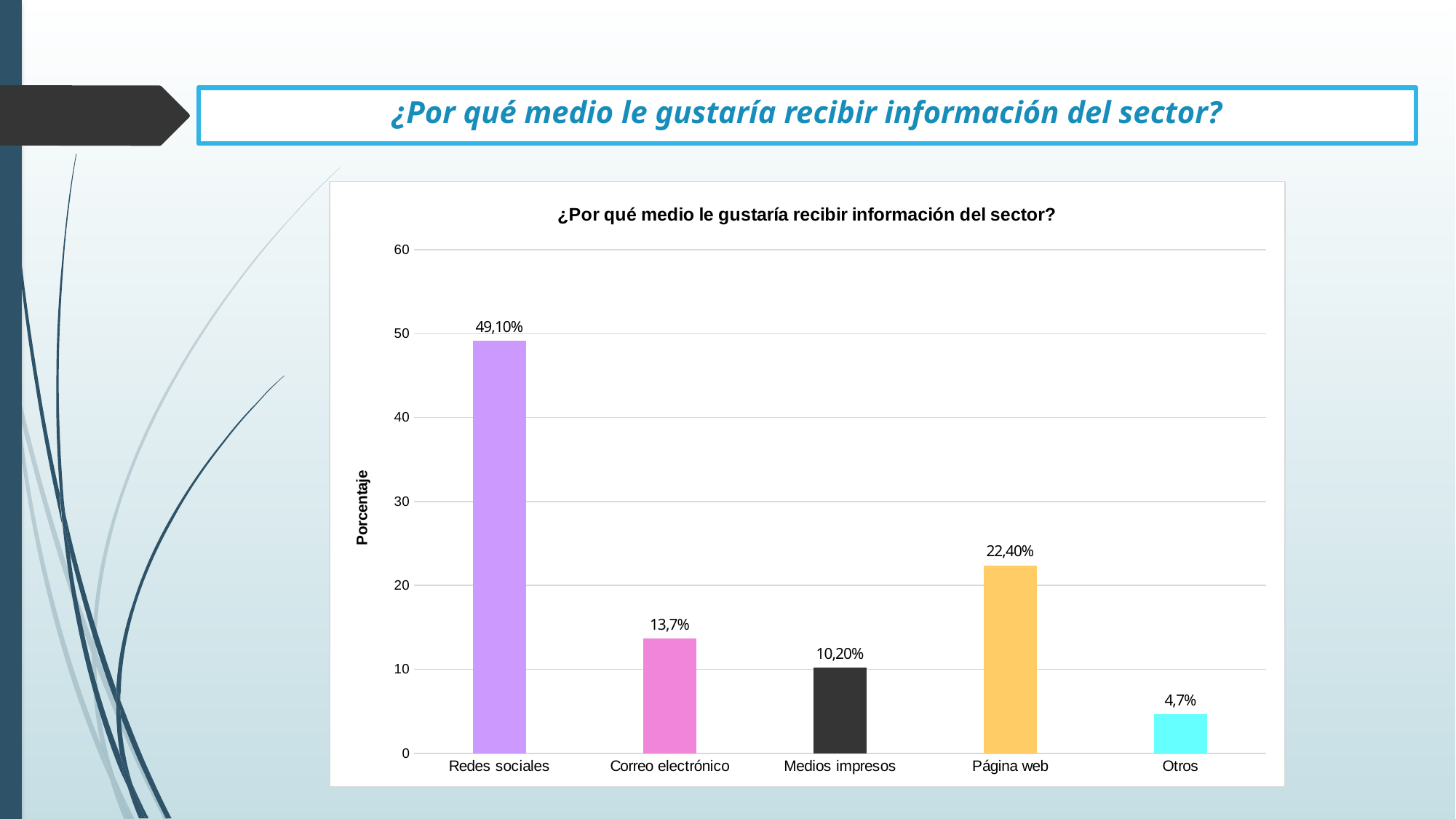
What is the value for Medios impresos? 10,20% Is the value for Página web greater or less than 20? greater Which category has the highest value? Redes sociales What is the value for Página web? 22,40% What is the value for Redes sociales? 49,10% Which is larger, the value for Correo electrónico or the value for Medios impresos? Correo electrónico Which category has the lowest value? Otros What is the difference between the values for Redes sociales and Página web? 26,70% What is the label of the vertical axis? Porcentaje How many categories are shown on the x axis? 5 What is the value for Otros? 4,7% What kind of chart is shown on the slide? bar chart